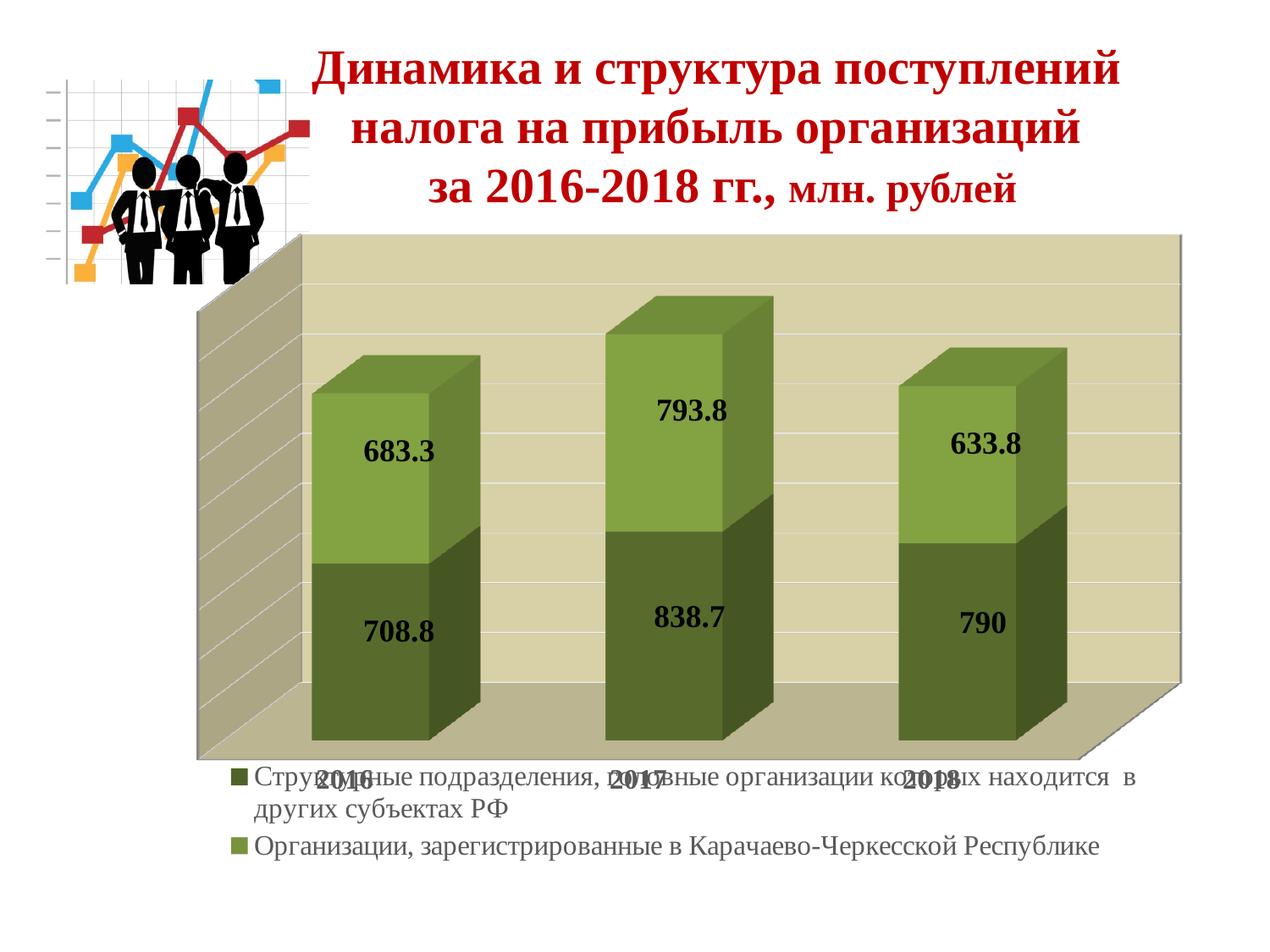
What is the value for 'Организации, зарегистрированные в Карачаево-Черкесской Республике' in 2017? 793.8 What type of chart is shown on the slide? Stacked bar chart What unit of measurement is stated in the chart title? млн. рублей Which is larger in 2018: the value for 'Структурные подразделения...' or for 'Организации, зарегистрированные в Карачаево-Черкесской Республике'? Структурные подразделения, головные организации которых находится в других субъектах РФ How many series does the legend list? 2 In which year is the value for 'Структурные подразделения, головные организации которых находится в других субъектах РФ' the highest? 2017 How many years (categories) are shown on the x axis? 3 What is the value for 'Организации, зарегистрированные в Карачаево-Черкесской Республике' in 2016? 683.3 In which year is the value for 'Организации, зарегистрированные в Карачаево-Черкесской Республике' the lowest? 2018 What is the value for 'Структурные подразделения, головные организации которых находится в других субъектах РФ' in 2018? 790 What is the difference between the 2017 and 2016 values for 'Структурные подразделения, головные организации которых находится в других субъектах РФ'? 129.9 What is the total of the stacked bar for 2017? 1632.5